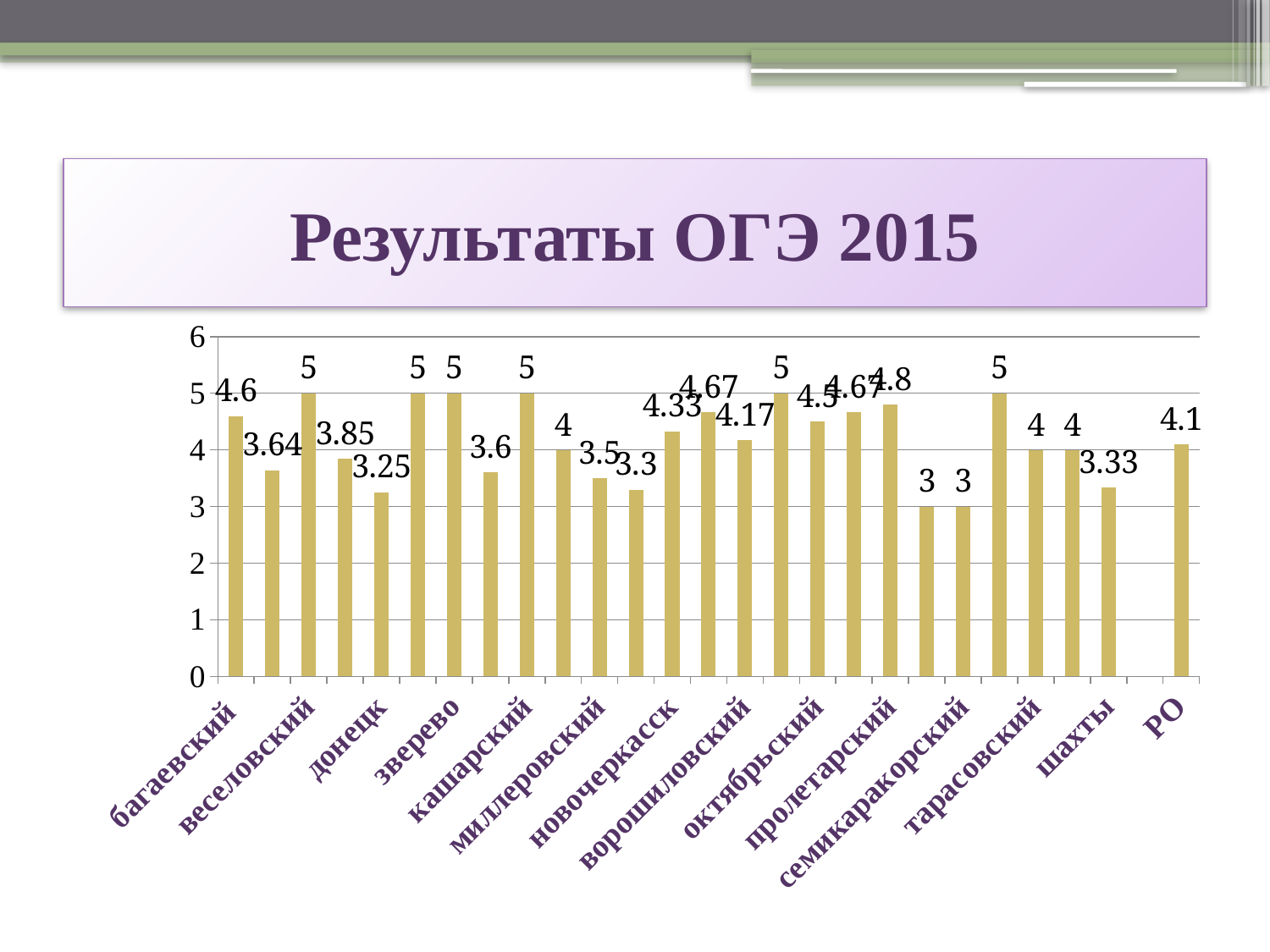
What is the value for шахты? 3.33 What is the difference between the values for пролетарский and семикаракорский? 1.8 What kind of chart is shown on the slide? bar chart What is the value for донецк? 3.25 What is the value for пролетарский? 4.8 What is the value for РО? 4.1 What is the value for новочеркасск? 4.33 What is the title of the slide? Результаты ОГЭ 2015 Is the value for зверево greater or less than 4? greater Which has the larger value, багаевский or РО? багаевский What is the value for семикаракорский? 3 What is the value for багаевский? 4.6